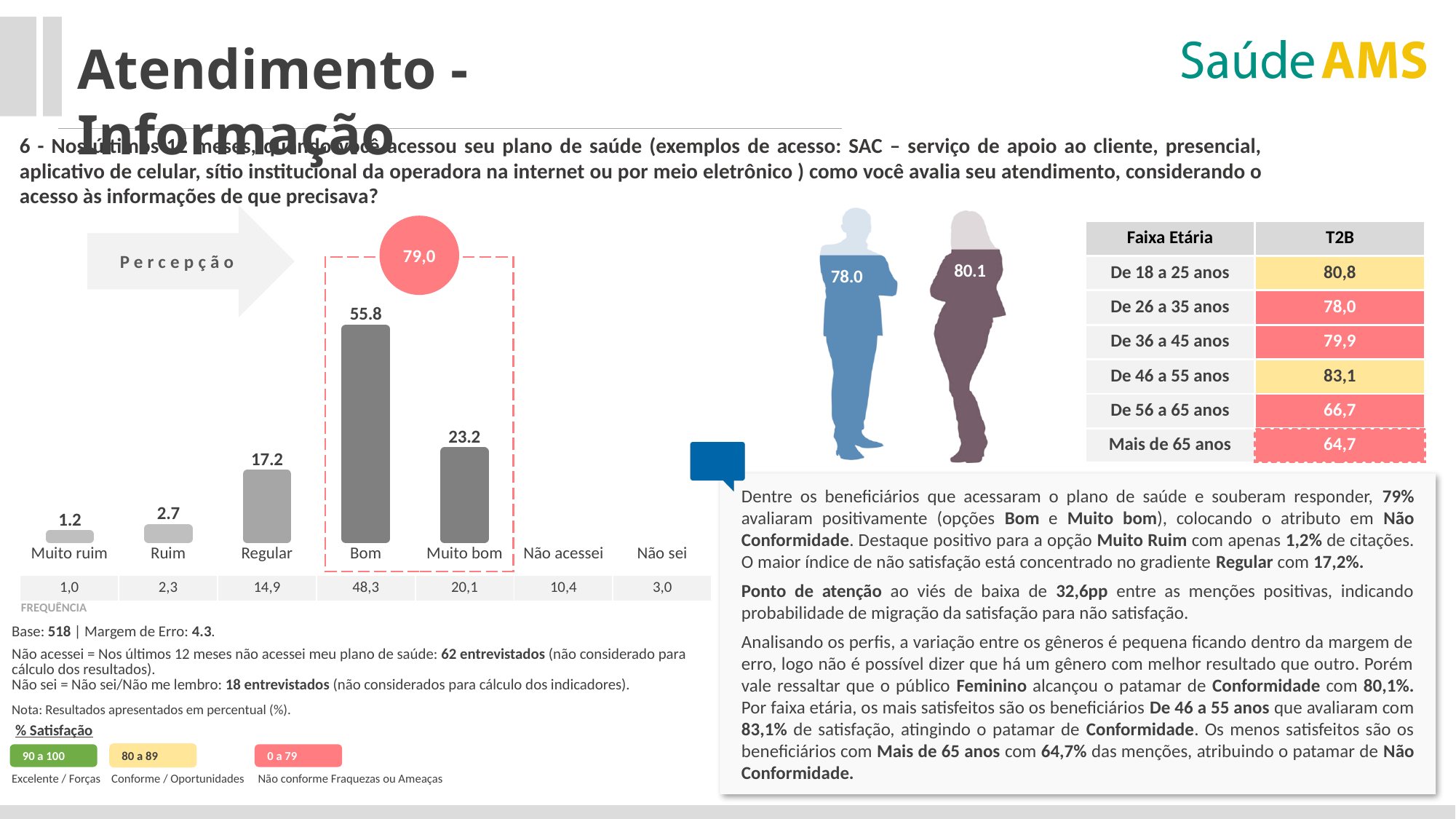
Which category has the highest bar in the bar chart? Bom In the Faixa Etária table, which age group has the lowest T2B value? Mais de 65 anos In the bar chart, what is the value for Bom? 55.8 What type of chart is used to show the evaluation of service (Muito ruim to Muito bom)? bar chart In the bar chart, what is the difference between the values for Bom and Muito bom? 32.6 How many categories are labelled along the x axis of the bar chart? 7 In the Faixa Etária table, what is the T2B value for De 46 a 55 anos? 83,1 In the bar chart, which is larger: the value for Regular or the value for Muito bom? Muito bom In the bar chart, what is the value for Muito ruim? 1.2 Which category has the lowest bar in the bar chart? Muito ruim In the bar chart, what is the value for Regular? 17.2 What value is shown in the red circle above the dashed box around Bom and Muito bom? 79,0